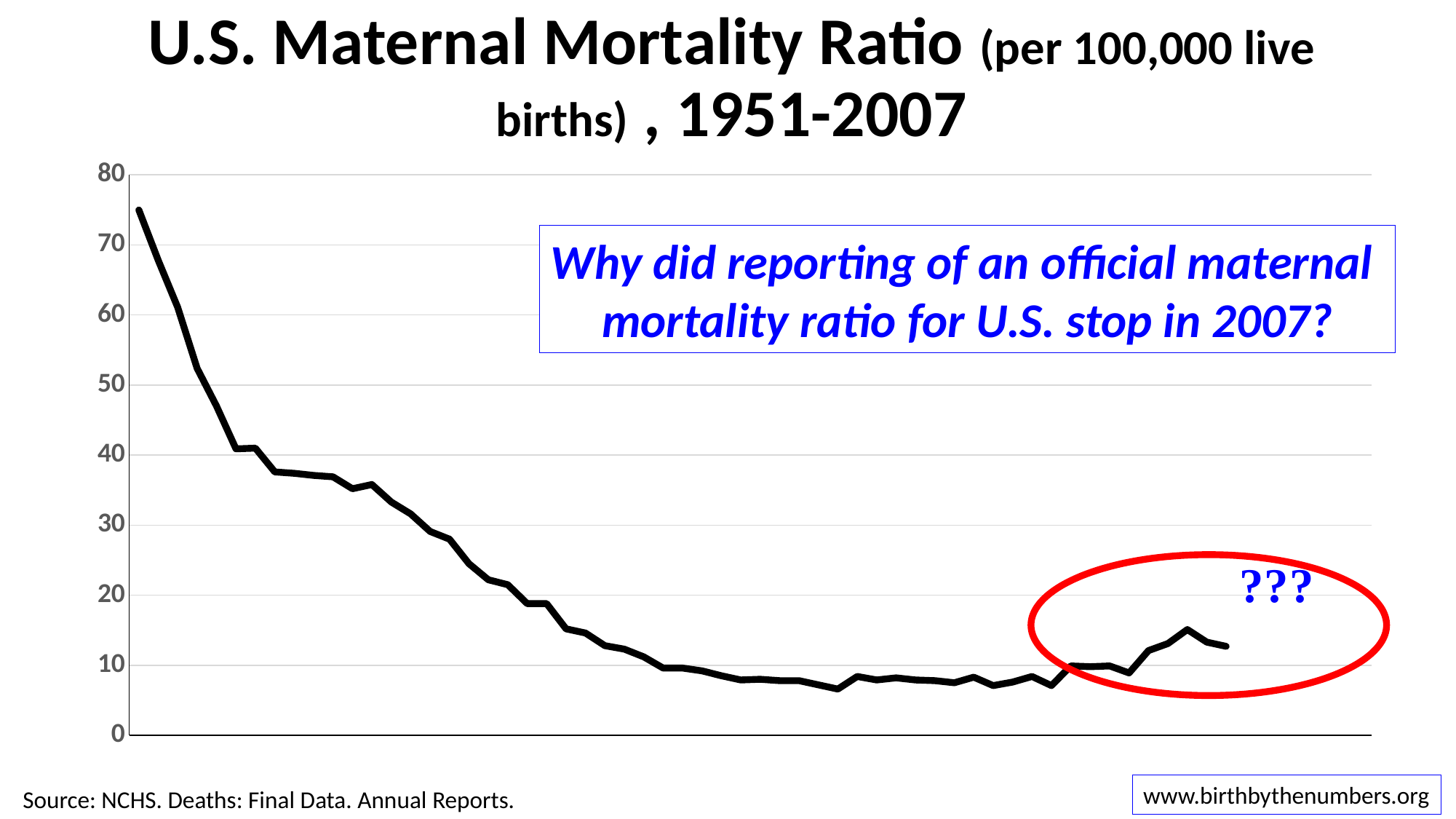
What is the title of the chart? U.S. Maternal Mortality Ratio (per 100,000 live births), 1951-2007 Is the lowest point on the line greater or less than 10? less Does the maternal mortality ratio generally rise or fall from the start of the series to the end? fall Is the value at the first point of the line (1951) greater or less than 70? greater Is the value at the first point of the line (1951) greater or less than 80? less What is the highest tick value shown on the y axis? 80 What kind of chart is shown on the slide? line chart Which is larger, the value at the first point of the line or the value at the last point? the first point